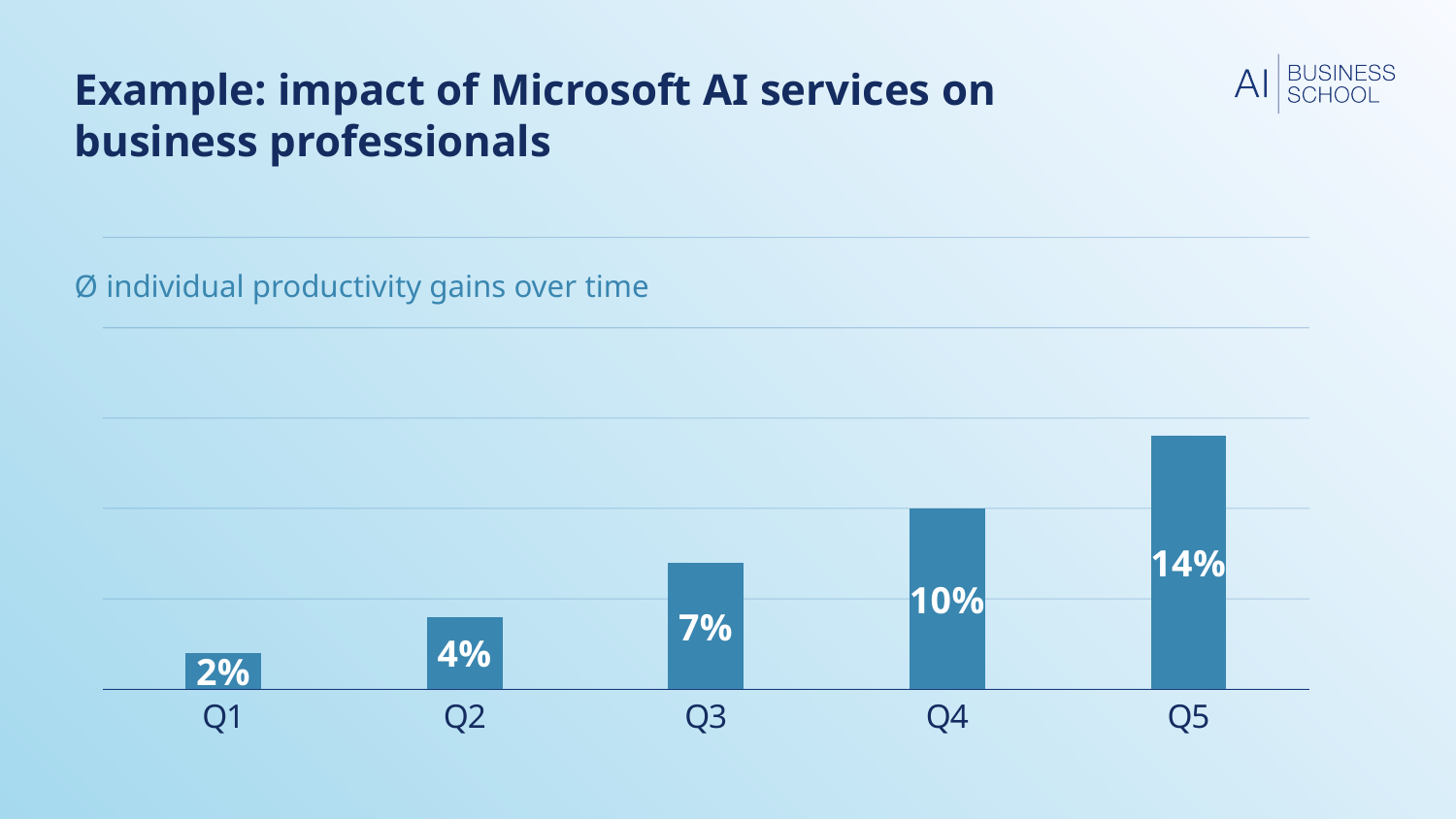
What is the productivity gain shown for Q3? 7% What is the subtitle of the chart? Ø individual productivity gains over time Which quarter has the lowest productivity gain? Q1 Which quarter has the highest productivity gain? Q5 What is the difference between the productivity gains for Q5 and Q4? 4% What is the difference between the productivity gains for Q3 and Q2? 3% Which is larger, the productivity gain for Q2 or for Q4? Q4 Do the productivity gains rise or fall from Q1 to Q5? Rise What is the productivity gain shown for Q5? 14% What kind of chart is shown on the slide? Bar chart What is the productivity gain shown for Q1? 2% How many quarters are shown on the chart? 5